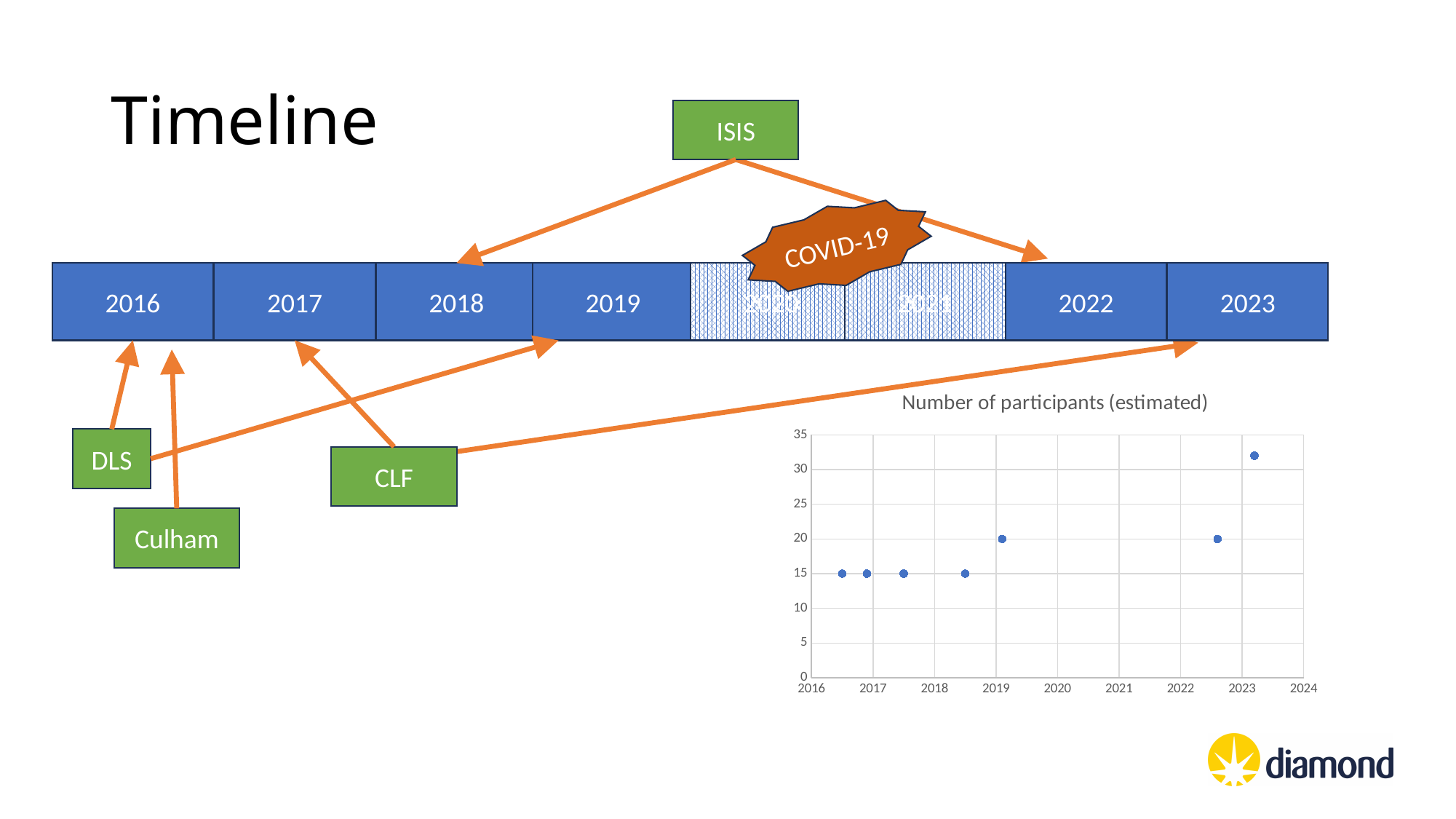
Overall, do the values in the chart rise or fall from 2016 to 2023? rise What is the highest value shown on the y axis of the chart? 35 Is the point plotted just after 2019 greater or less than 25? less Around which year on the x axis does the highest point in the chart occur? 2023 What is the title of the chart on the slide? Number of participants (estimated) Is the point plotted just after 2019 greater or less than 15? greater How many data points are plotted in the chart? 7 What kind of chart is shown on the slide? scatter chart Are the points plotted between 2016 and 2019 greater or less than 20? less Which is larger: the point plotted near 2023 or the point plotted near 2022.5? the point near 2023 How many points in the chart lie on the 15 gridline? 4